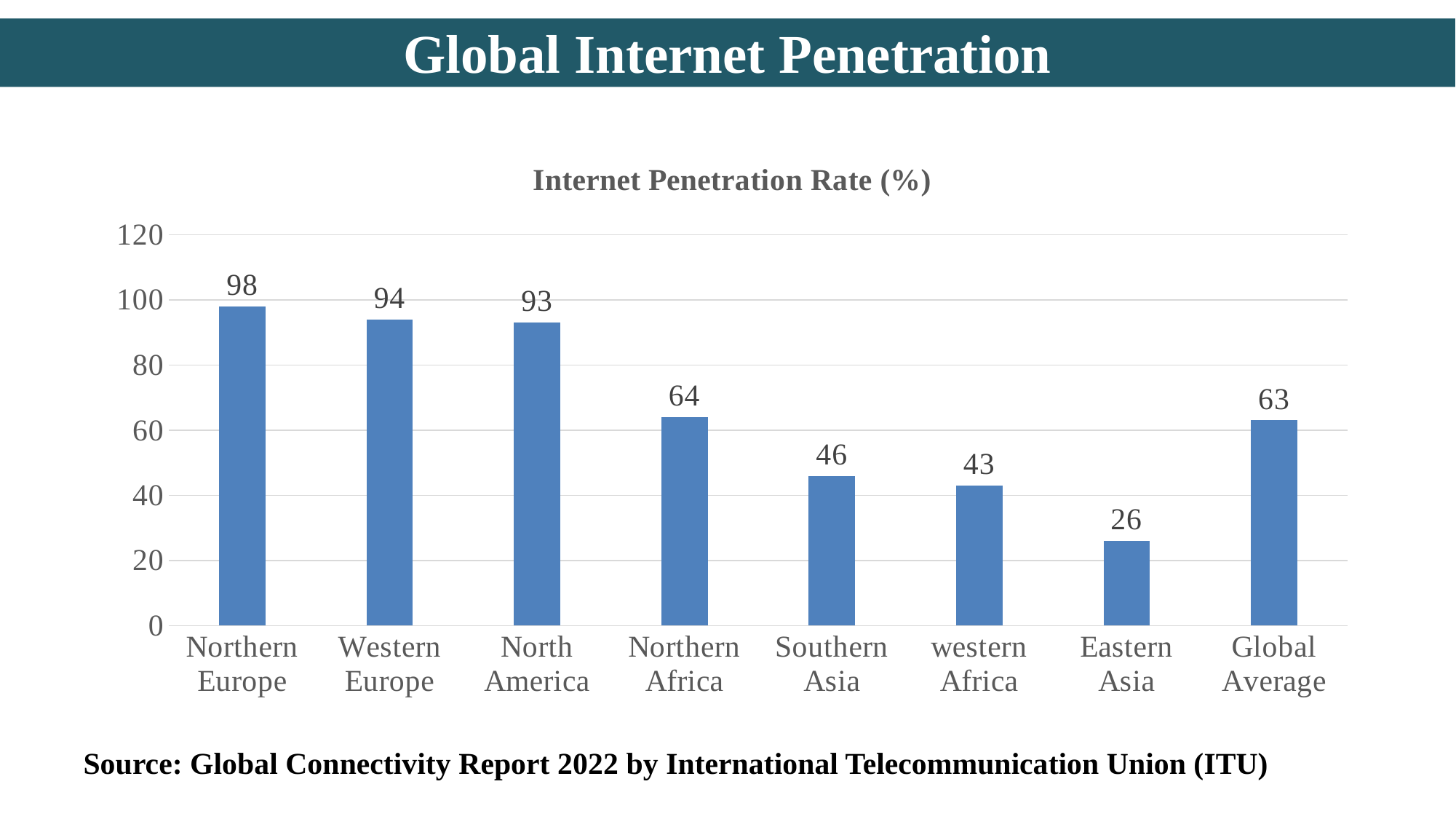
Is the value for North America greater or less than 80? greater What is the difference between the values for Northern Africa and Southern Asia? 18 How many categories are shown on the x axis? 8 Which category has the lowest internet penetration rate? Eastern Asia What is the internet penetration rate for Northern Europe? 98 What kind of chart is shown on the slide? bar chart What is the difference between the values for Northern Europe and Eastern Asia? 72 Which category has the highest internet penetration rate? Northern Europe Which is larger, the value for Southern Asia or the value for western Africa? Southern Asia What is the title of the chart? Internet Penetration Rate (%) What is the value shown for Global Average? 63 What is the internet penetration rate for Eastern Asia? 26